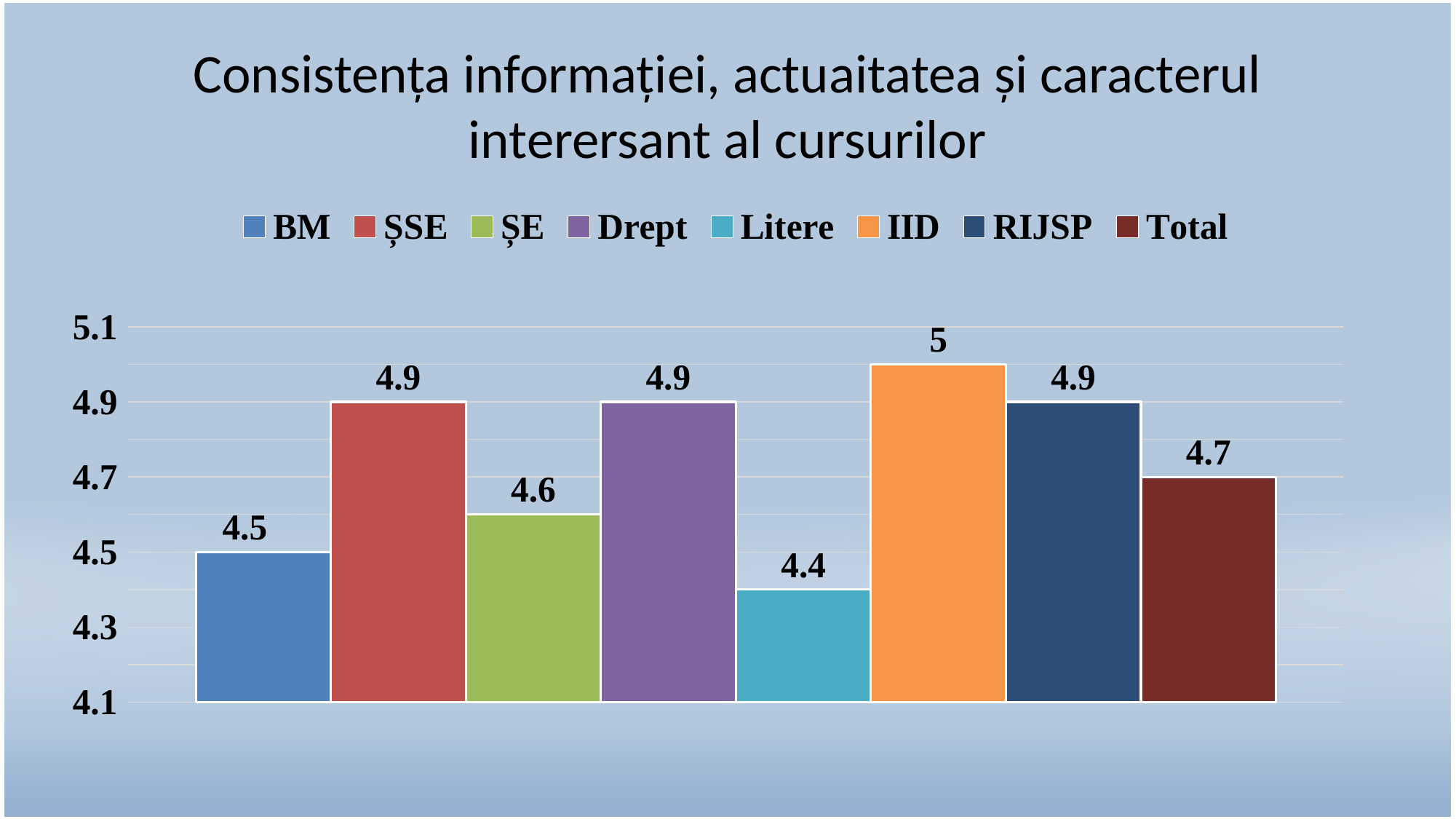
How many bars are shown in the chart? 8 What is the difference between the values for IID and Litere? 0.6 What is the value for Litere? 4.4 What is the value for BM? 4.5 What kind of chart is shown on the slide? Bar chart How many entries does the legend list? 8 What is the value for Total? 4.7 What is the difference between the values for ȘSE and ȘE? 0.3 What is the value for IID? 5 Which category has the lowest value? Litere Which category has the highest value? IID Which is larger, the value for ȘE or the value for Total? Total